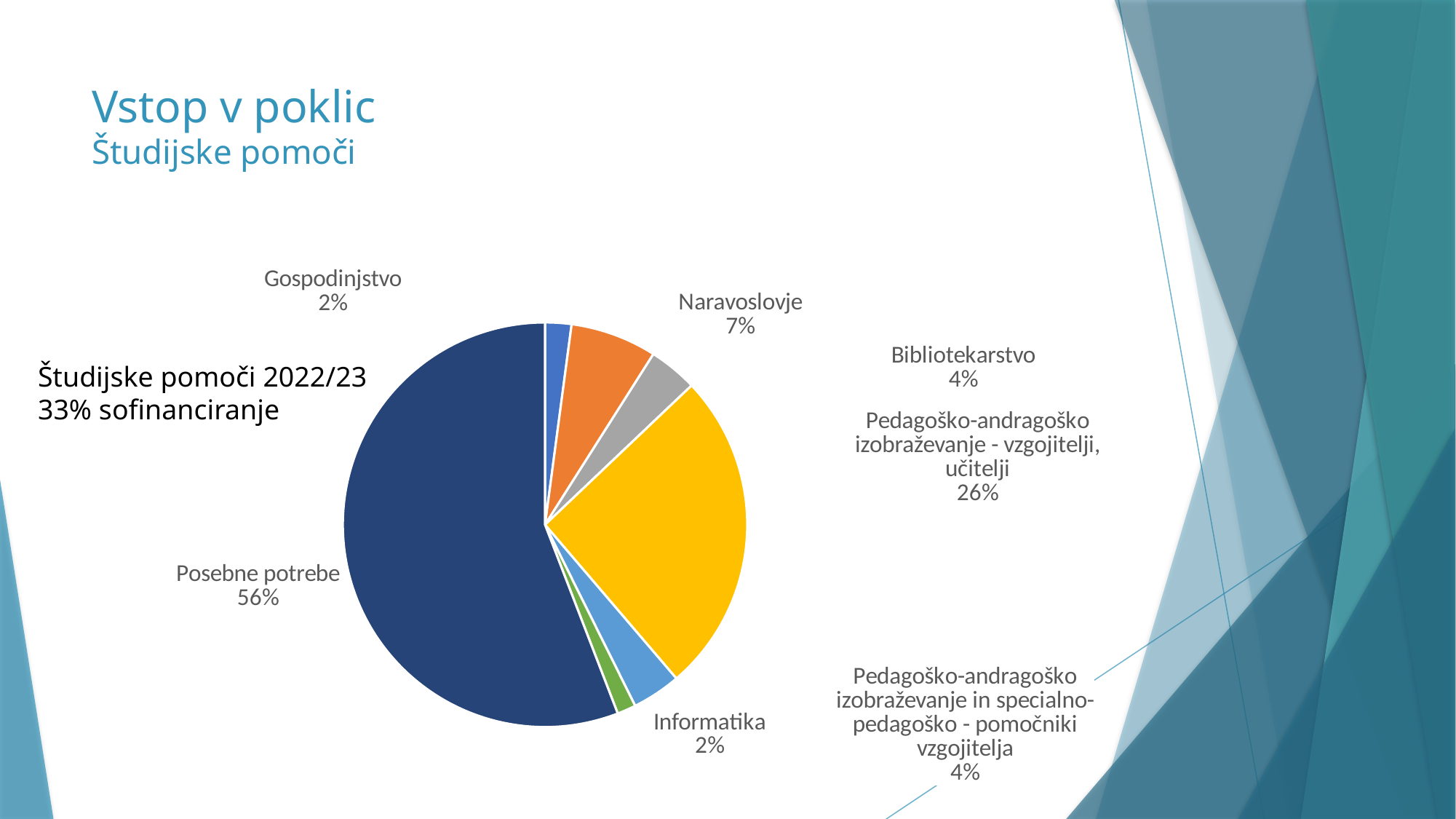
What percentage is shown for Bibliotekarstvo? 4% What percentage is shown for Gospodinjstvo? 2% What colour is the Posebne potrebe slice? Dark blue What percentage is shown for Informatika? 2% What percentage is shown for Pedagoško-andragoško izobraževanje - vzgojitelji, učitelji? 26% What share of the pie does Posebne potrebe hold? 56% Which category has the larger share, Naravoslovje or Bibliotekarstvo? Naravoslovje Which category has the largest slice of the pie? Posebne potrebe What percentage is shown for Naravoslovje? 7% How many slices does the pie chart have? 7 What kind of chart is shown on the slide? Pie chart What is the difference in percentage points between Posebne potrebe and Pedagoško-andragoško izobraževanje - vzgojitelji, učitelji? 30